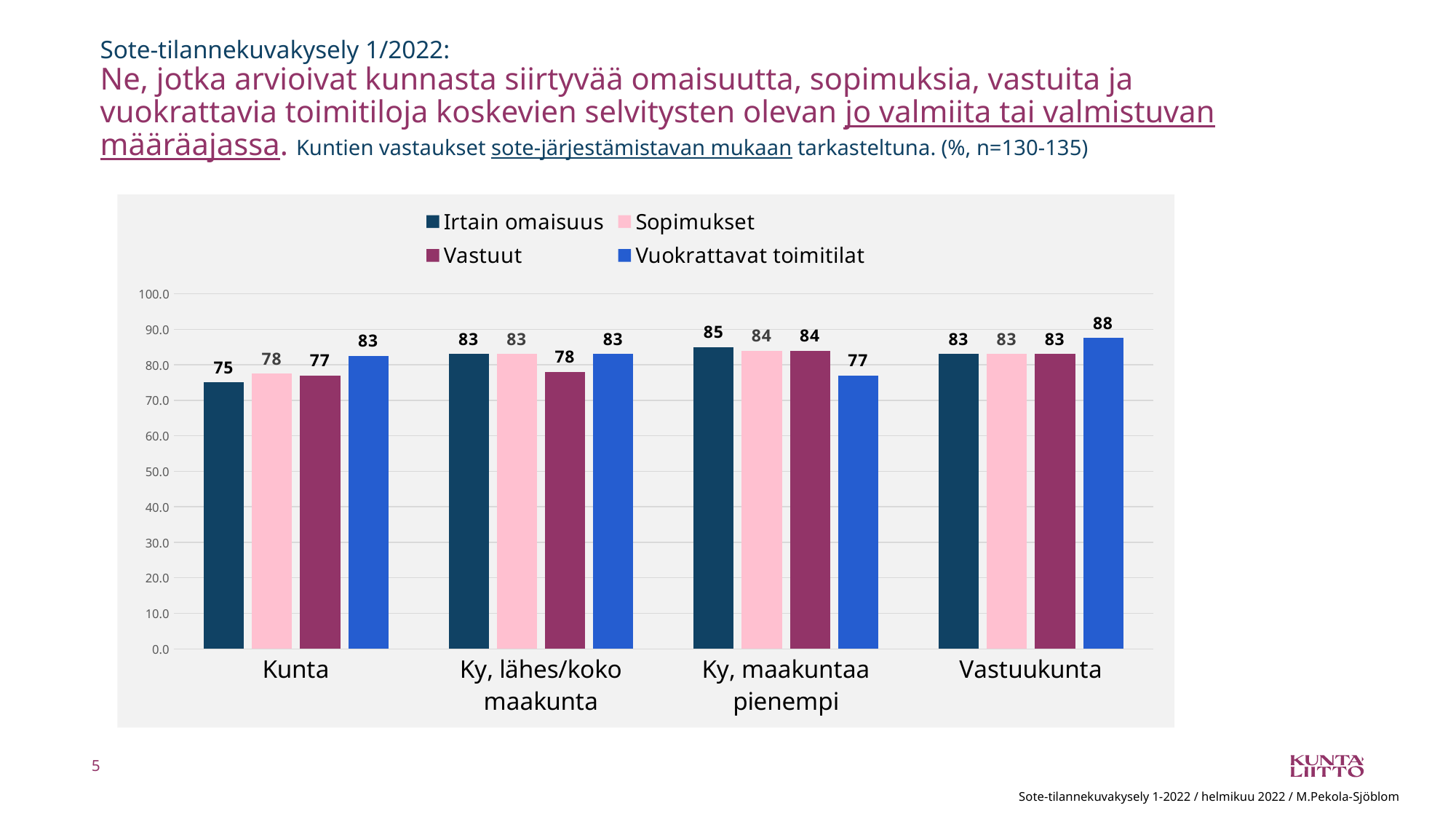
What is the value for Vuokrattavat toimitilat in the Vastuukunta category? 88 How many series does the legend list? 4 What is the value for Sopimukset in the Kunta category? 78 Which category has the highest value for Vuokrattavat toimitilat? Vastuukunta What is the value for Irtain omaisuus in the Kunta category? 75 What is the difference between the Vuokrattavat toimitilat value and the Irtain omaisuus value in the Kunta category? 8 How many categories are shown on the x axis? 4 Is the value for Irtain omaisuus in the Ky, maakuntaa pienempi category greater or less than 80? greater Which category has the lowest value for Irtain omaisuus? Kunta What is the value for Vastuut in the Ky, maakuntaa pienempi category? 84 What kind of chart is shown on the slide? Bar chart Which is larger: Vastuut in Ky, lähes/koko maakunta or Vastuut in Ky, maakuntaa pienempi? Ky, maakuntaa pienempi